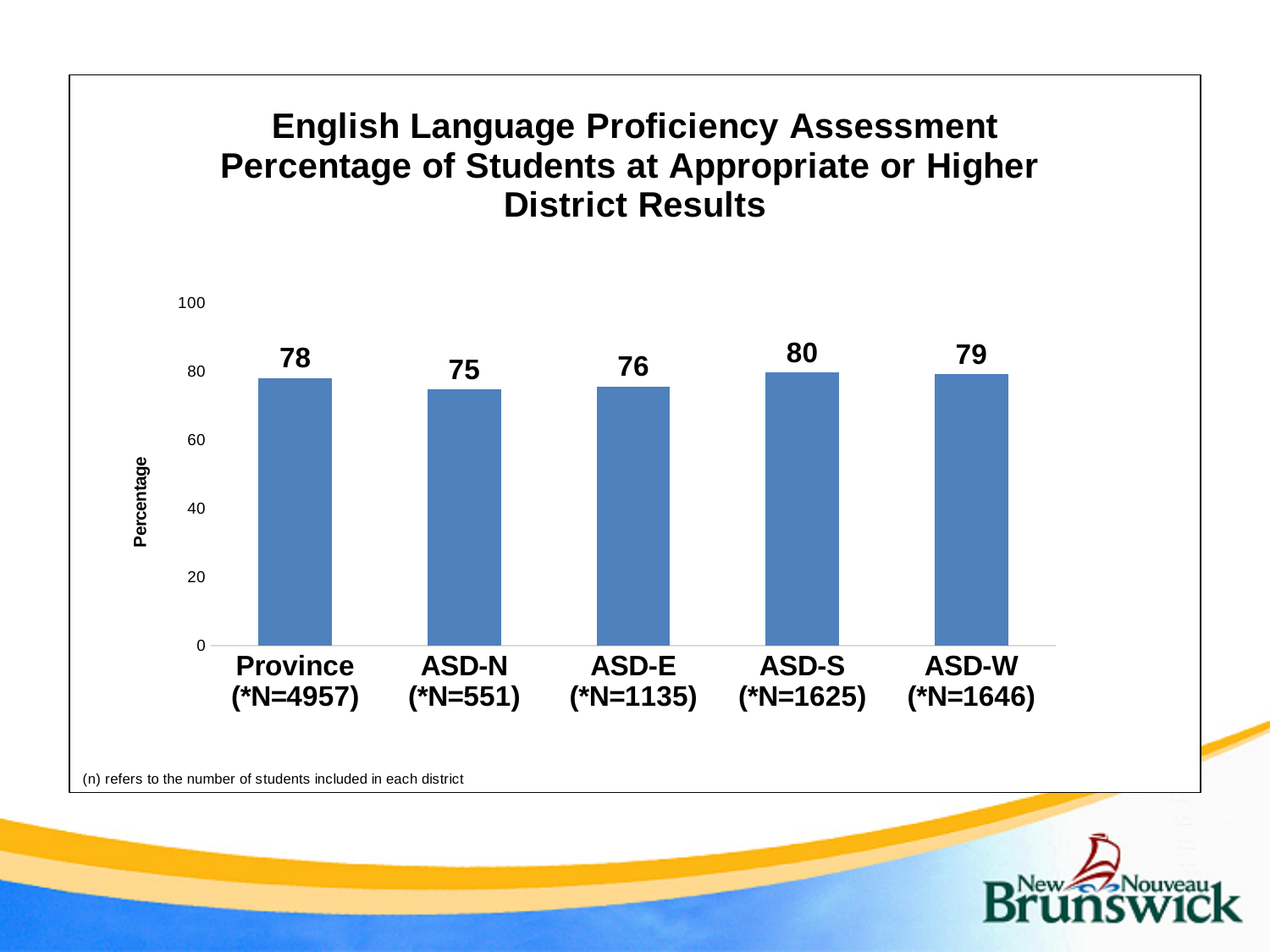
How many categories are shown on the x axis? 5 What is the label of the y axis? Percentage What is the difference between the values for ASD-S and ASD-N? 5 Which is larger, the value for ASD-W or the value for ASD-E? ASD-W What is the value for ASD-S (*N=1625)? 80 What kind of chart is shown on the slide? bar chart Which category has the highest value? ASD-S (*N=1625) What is the value for ASD-W (*N=1646)? 79 Which category has the lowest value? ASD-N (*N=551) What is the value for ASD-E (*N=1135)? 76 What is the value for Province (*N=4957)? 78 What is the value for ASD-N (*N=551)? 75